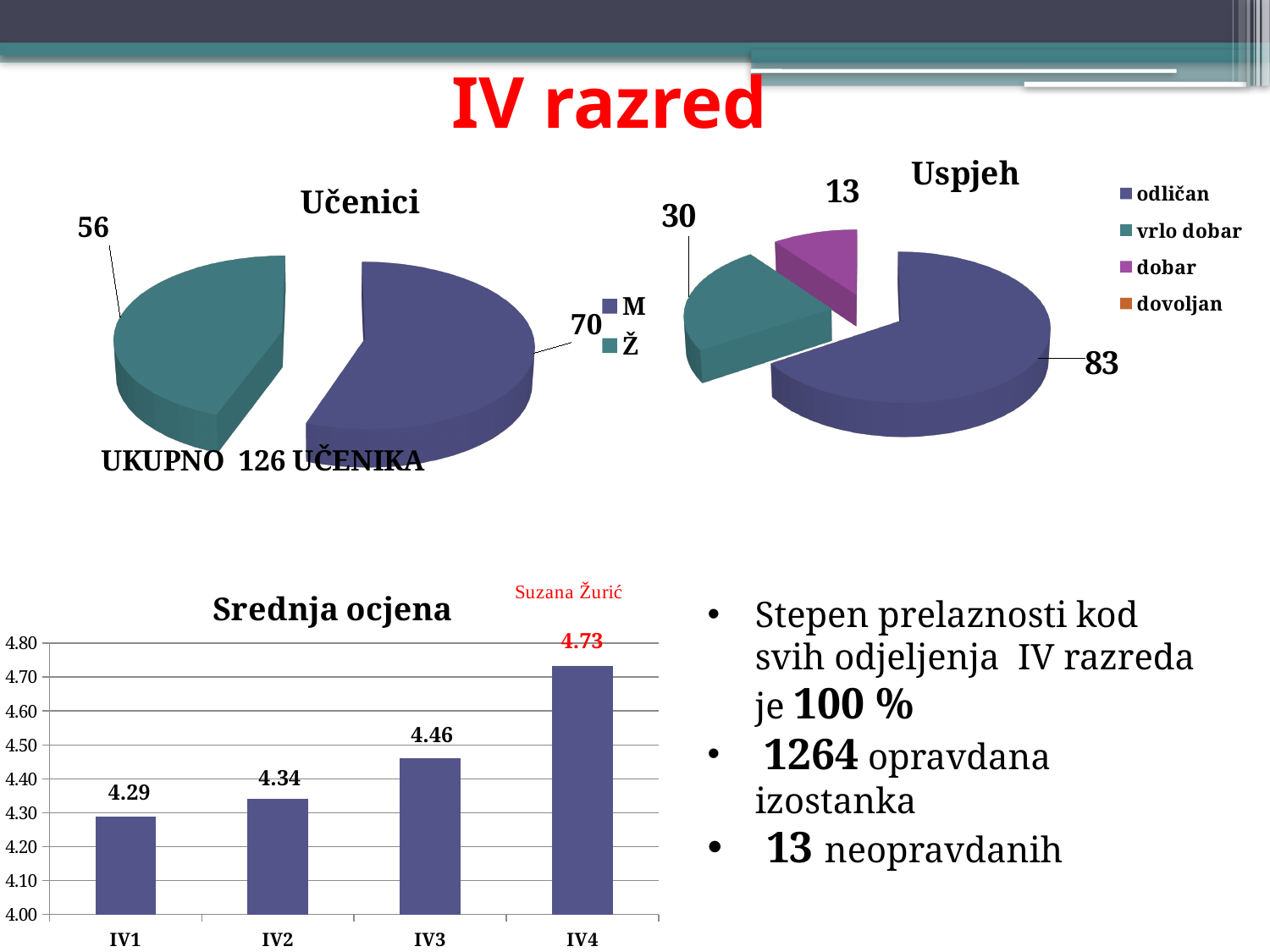
In the 'Srednja ocjena' chart, what is the value for IV2? 4.34 In the 'Učenici' pie chart, what is the value for M? 70 In the 'Srednja ocjena' chart, which category has the lowest value? IV1 In the 'Učenici' pie chart, what is the value for Ž? 56 In the 'Uspjeh' pie chart, which category has the smallest labelled slice? dobar In the 'Uspjeh' pie chart, what is the value for vrlo dobar? 30 In the 'Srednja ocjena' chart, do the values rise or fall from IV1 to IV4? rise In the 'Srednja ocjena' chart, what is the difference between the values for IV4 and IV3? 0.27 In the 'Uspjeh' pie chart, what is the value for odličan? 83 In the 'Učenici' pie chart, what is the difference between the M and Ž values? 14 In the 'Srednja ocjena' chart, which category has the highest value? IV4 In the 'Uspjeh' pie chart, how many categories does the legend list? 4